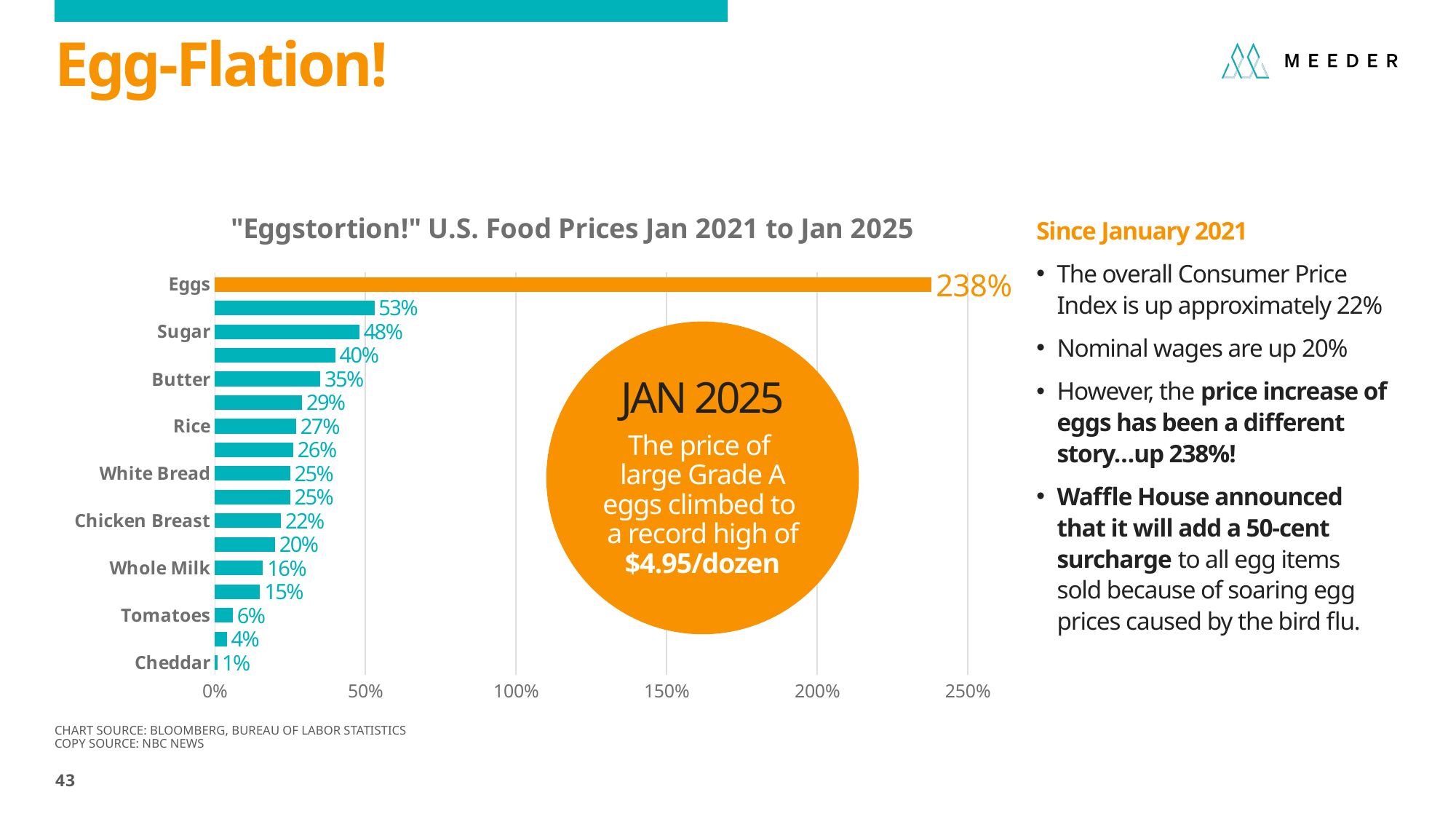
Which is larger, the value for Butter or the value for Rice? Butter What is the title of the chart? "Eggstortion!" U.S. Food Prices Jan 2021 to Jan 2025 What is the value for Eggs? 238% What kind of chart is shown? bar chart Is the value for Eggs greater or less than 200%? greater What is the value for Sugar? 48% What is the value for Cheddar? 1% What is the value for Whole Milk? 16% Which category has the highest value? Eggs What is the value for Butter? 35% What is the difference between the values for Eggs and Sugar? 190% Which labeled category has the lowest value? Cheddar